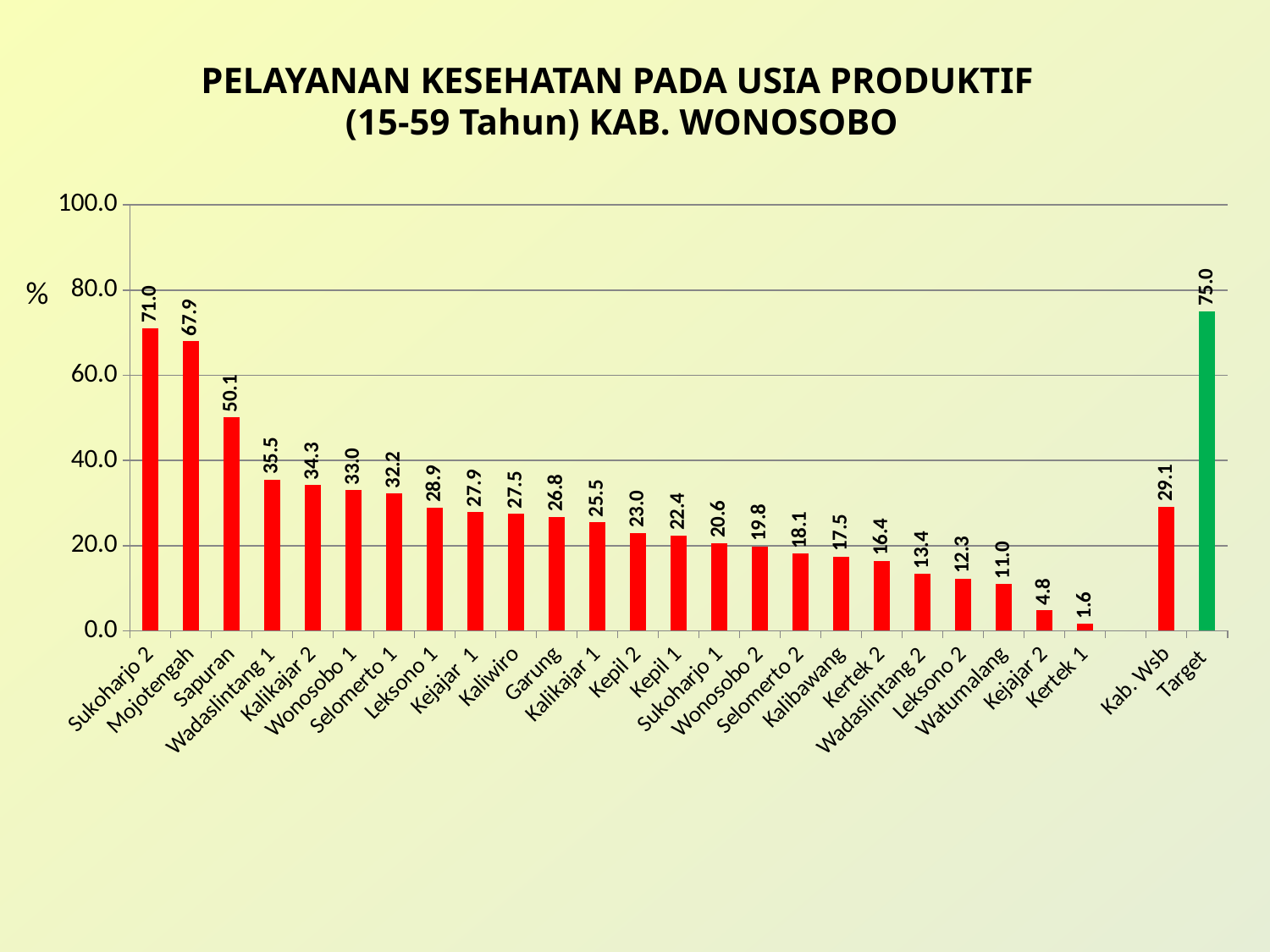
What is the difference between Sukoharjo 2 and Mojotengah? 3.1 Which category has the lowest value on the chart? Kertek 1 What is the value for Kab. Wsb? 29.1 How many bars are plotted on the chart? 26 What is the value for Kertek 1? 1.6 What is the value shown for Target? 75.0 What kind of chart is shown on the slide? Bar chart What is the value for Sukoharjo 2? 71.0 Which category has the highest value on the chart? Target What is the difference between the Target value and the Kab. Wsb value? 45.9 Which is larger, the value for Sapuran or the value for Wadaslintang 1? Sapuran What colour is the Target bar? Green